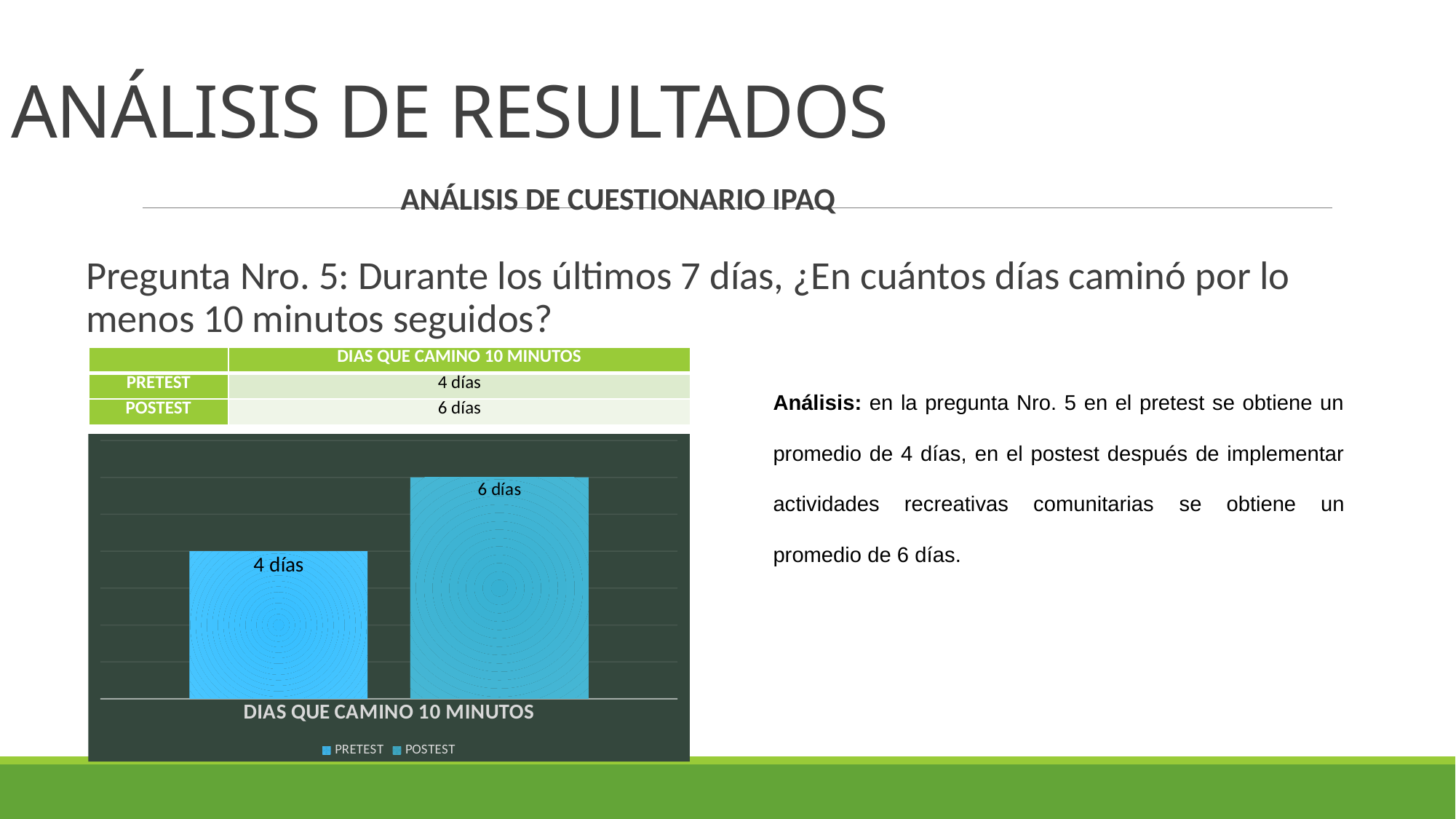
What is the category label shown on the x axis of the chart? DIAS QUE CAMINO 10 MINUTOS What is the difference in days between POSTEST and PRETEST? 2 días What kind of chart is shown on the slide? Bar chart What are the two entries listed in the chart legend? PRETEST and POSTEST Which series has the highest value in the chart? POSTEST How many series does the legend list? 2 What is the value for POSTEST in the chart? 6 días How many bars are plotted in the chart? 2 What is the value for PRETEST in the chart? 4 días Which series has the higher value, PRETEST or POSTEST? POSTEST Which series has the lowest value in the chart? PRETEST